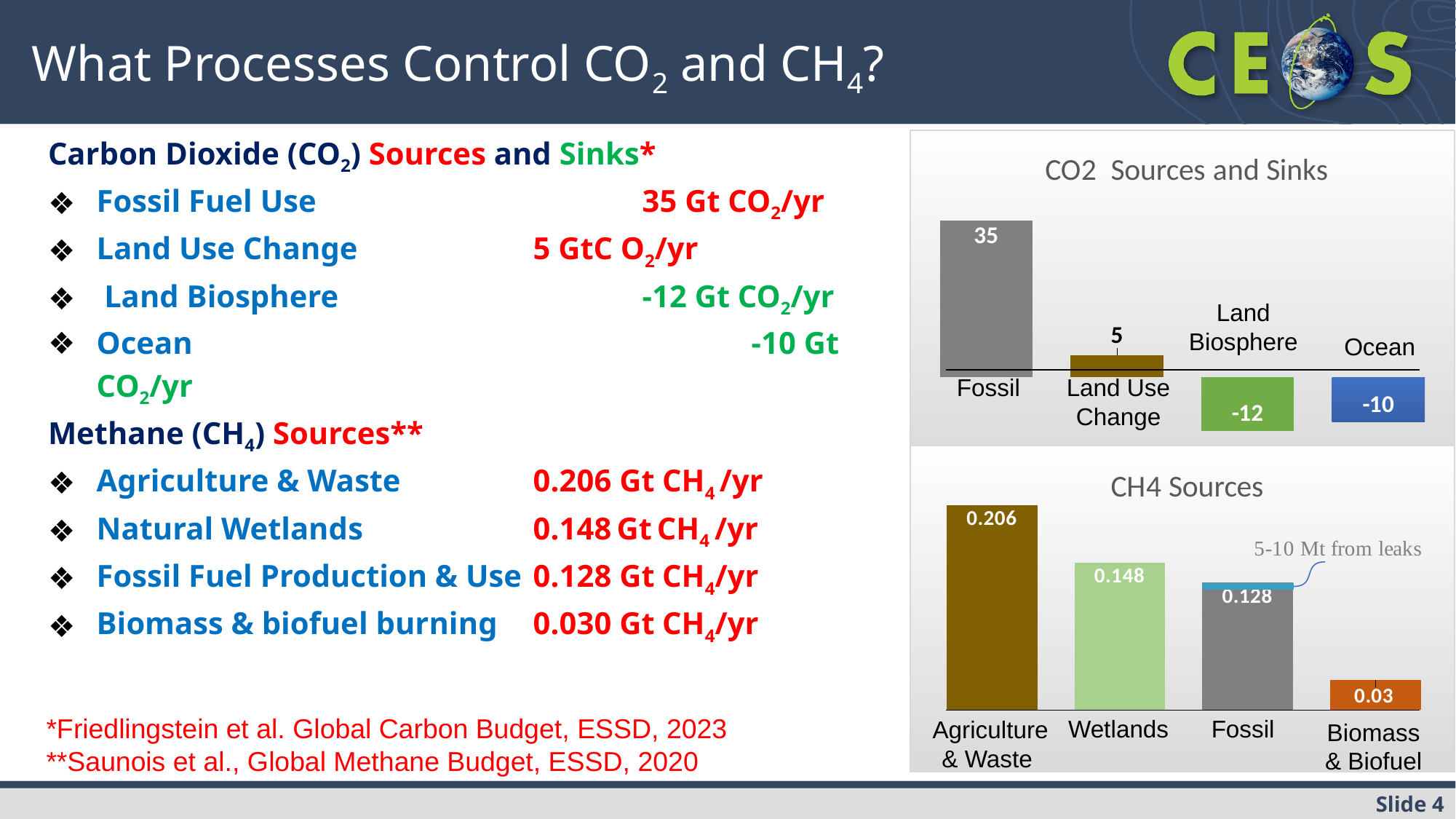
In the 'CH4 Sources' chart, which is larger: Wetlands or Fossil? Wetlands In the 'CO2 Sources and Sinks' chart, which category has the lowest value? Land Biosphere How many categories are shown in the 'CO2 Sources and Sinks' chart? 4 In the 'CO2 Sources and Sinks' chart, what is the difference between the Fossil value and the Land Use Change value? 30 In the 'CH4 Sources' chart, what is the value for Wetlands? 0.148 In the 'CO2 Sources and Sinks' chart, which category has the highest value? Fossil In the 'CH4 Sources' chart, which category has the highest value? Agriculture & Waste In the 'CO2 Sources and Sinks' chart, what is the value for Fossil? 35 In the 'CO2 Sources and Sinks' chart, what is the value for Ocean? -10 What type of chart is the 'CH4 Sources' chart? Bar chart In the 'CH4 Sources' chart, what is the value for Biomass & Biofuel? 0.03 In the 'CH4 Sources' chart, what is the difference between Agriculture & Waste and Fossil? 0.078